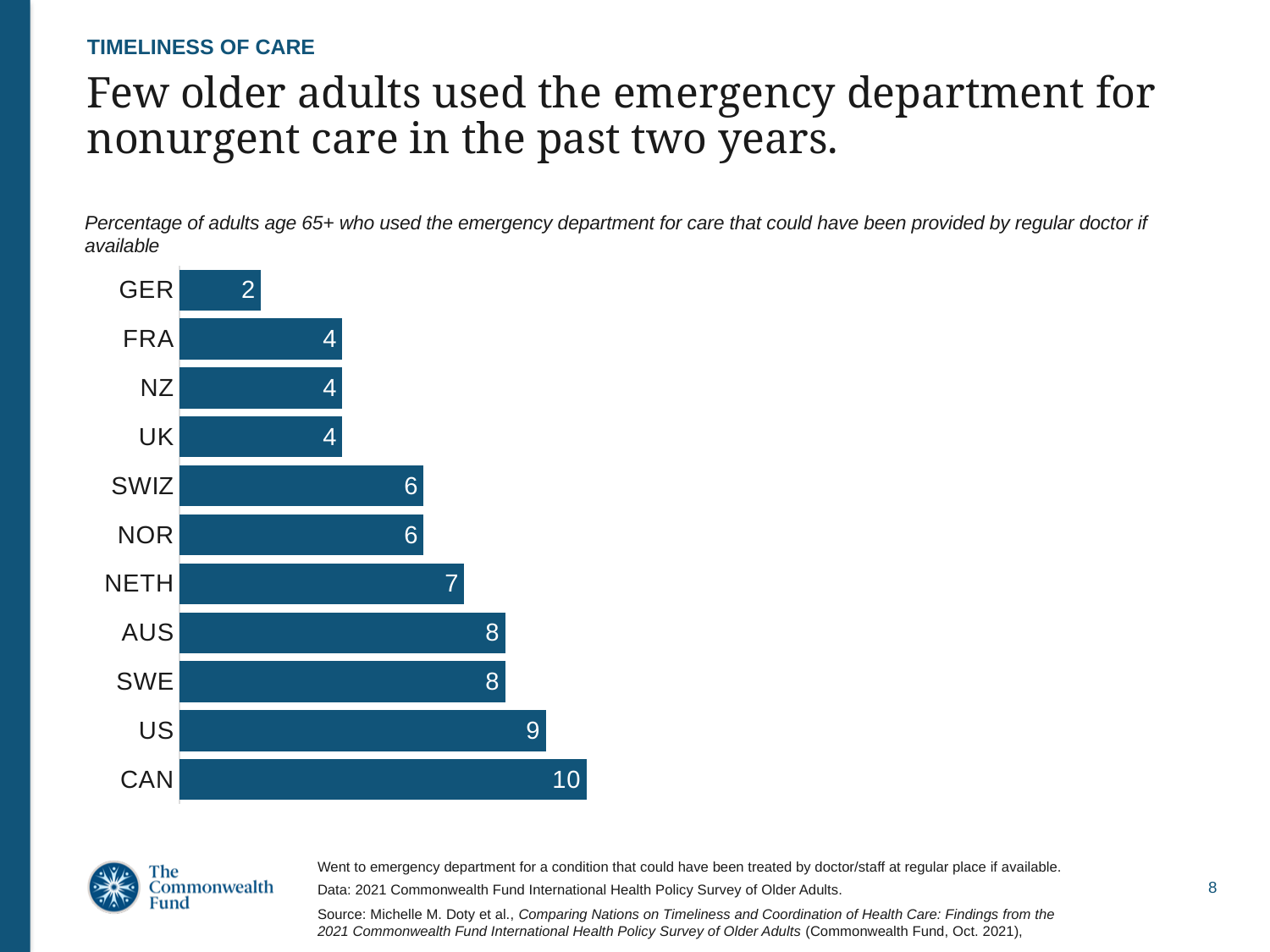
What is the value for CAN? 10 What kind of chart is shown on the slide? Bar chart Which country has the highest value? CAN Which country has the lowest value? GER What is the value for US? 9 What is the value for NETH? 7 What is the value for GER? 2 What is the difference between the values for CAN and GER? 8 Do the values rise or fall going from the top bar (GER) to the bottom bar (CAN)? Rise What is the difference between the values for US and SWIZ? 3 How many countries are shown in the chart? 11 Which is larger, the value for AUS or the value for UK? AUS